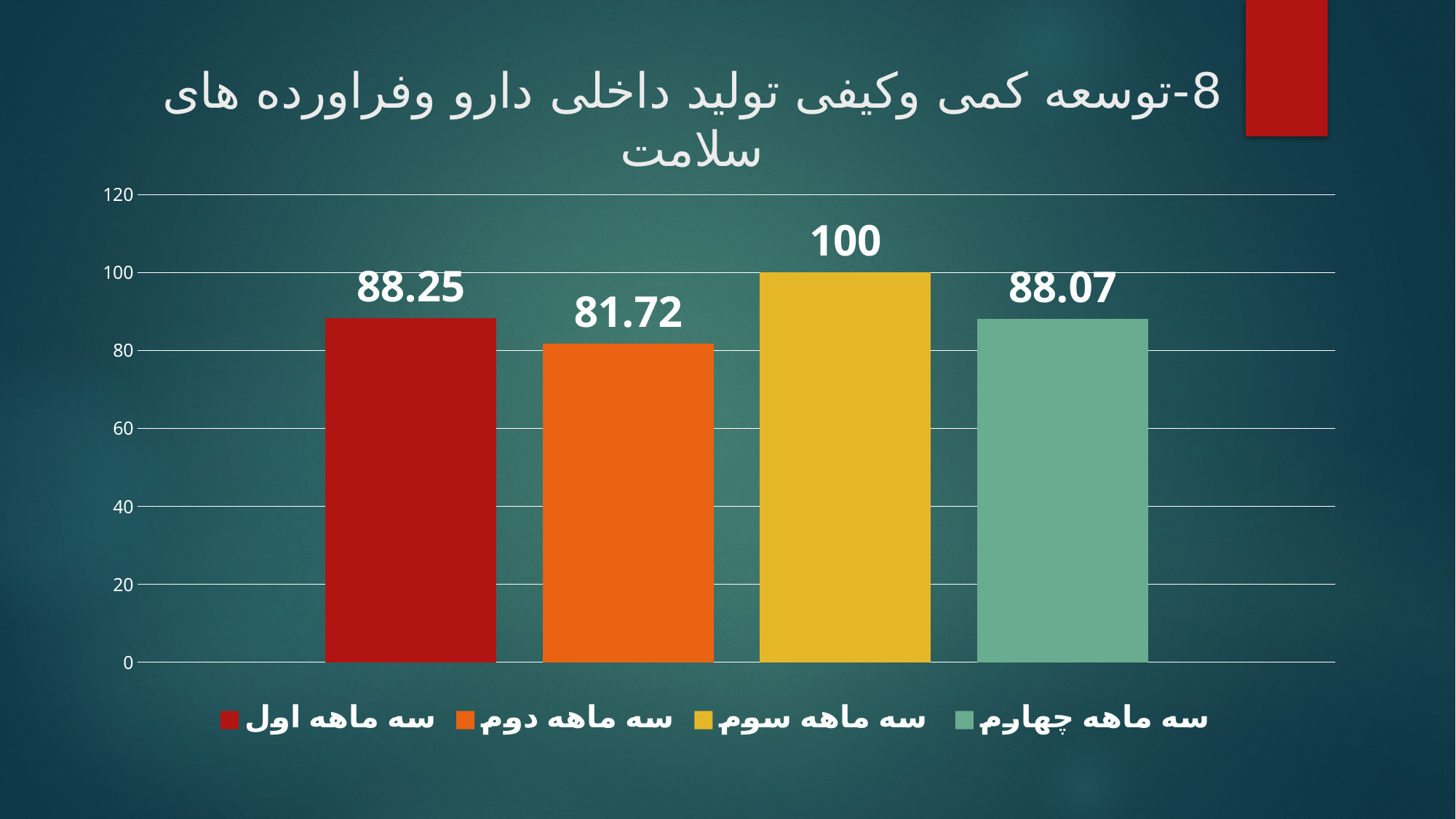
Which is larger, the value for سه ماهه اول or سه ماهه دوم? سه ماهه اول What is the value for سه ماهه اول? 88.25 Is the value for سه ماهه دوم greater or less than 100? less What kind of chart is shown on the slide? bar chart What is the value for سه ماهه سوم? 100 What is the difference between the values for سه ماهه سوم and سه ماهه دوم? 18.28 What is the value for سه ماهه دوم? 81.72 How many bars are plotted in the chart? 4 Which quarter has the lowest value? سه ماهه دوم What is the value for سه ماهه چهارم? 88.07 Which quarter has the highest value? سه ماهه سوم How many entries does the legend list? 4